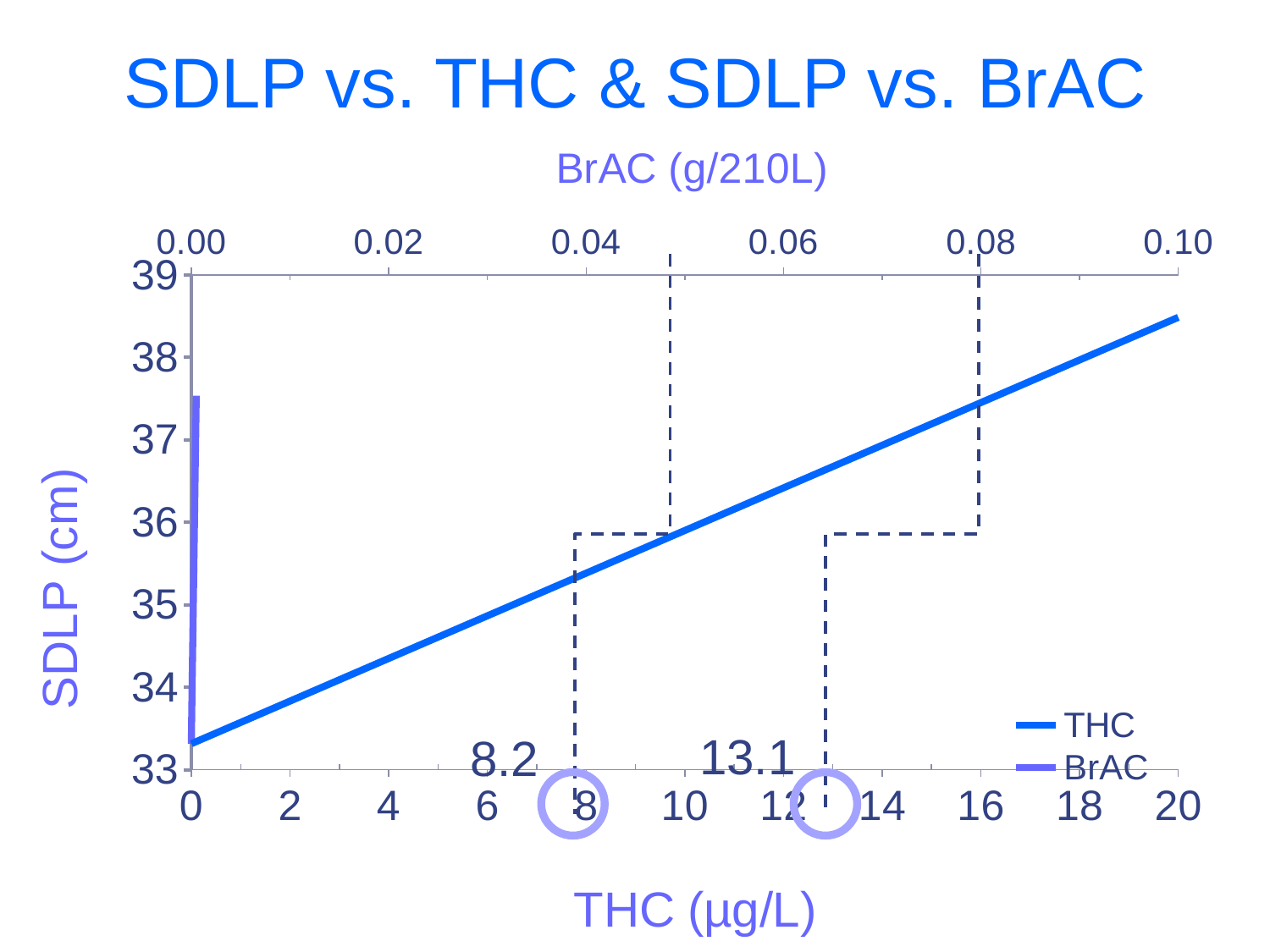
What is the title of the chart? SDLP vs. THC & SDLP vs. BrAC Is the SDLP value of the THC line at THC = 0 µg/L greater or less than 34? less Is the SDLP value of the THC line at THC = 20 µg/L greater or less than 38? greater How many series does the legend list? 2 What THC value is annotated on the chart as corresponding to a BrAC of 0.08 g/210L? 13.1 Which of the two annotated THC values is larger, the one at BrAC 0.05 or the one at BrAC 0.08? the one at BrAC 0.08 (13.1) What are the two series named in the legend? THC and BrAC Does the THC line rise or fall as THC (µg/L) increases along the x axis? rises What THC value is annotated on the chart as corresponding to a BrAC of 0.05 g/210L? 8.2 What is the difference between the two annotated THC values, 13.1 and 8.2? 4.9 What kind of chart is shown on the slide? line chart Is the SDLP value of the THC line at THC = 10 µg/L greater or less than 35? greater